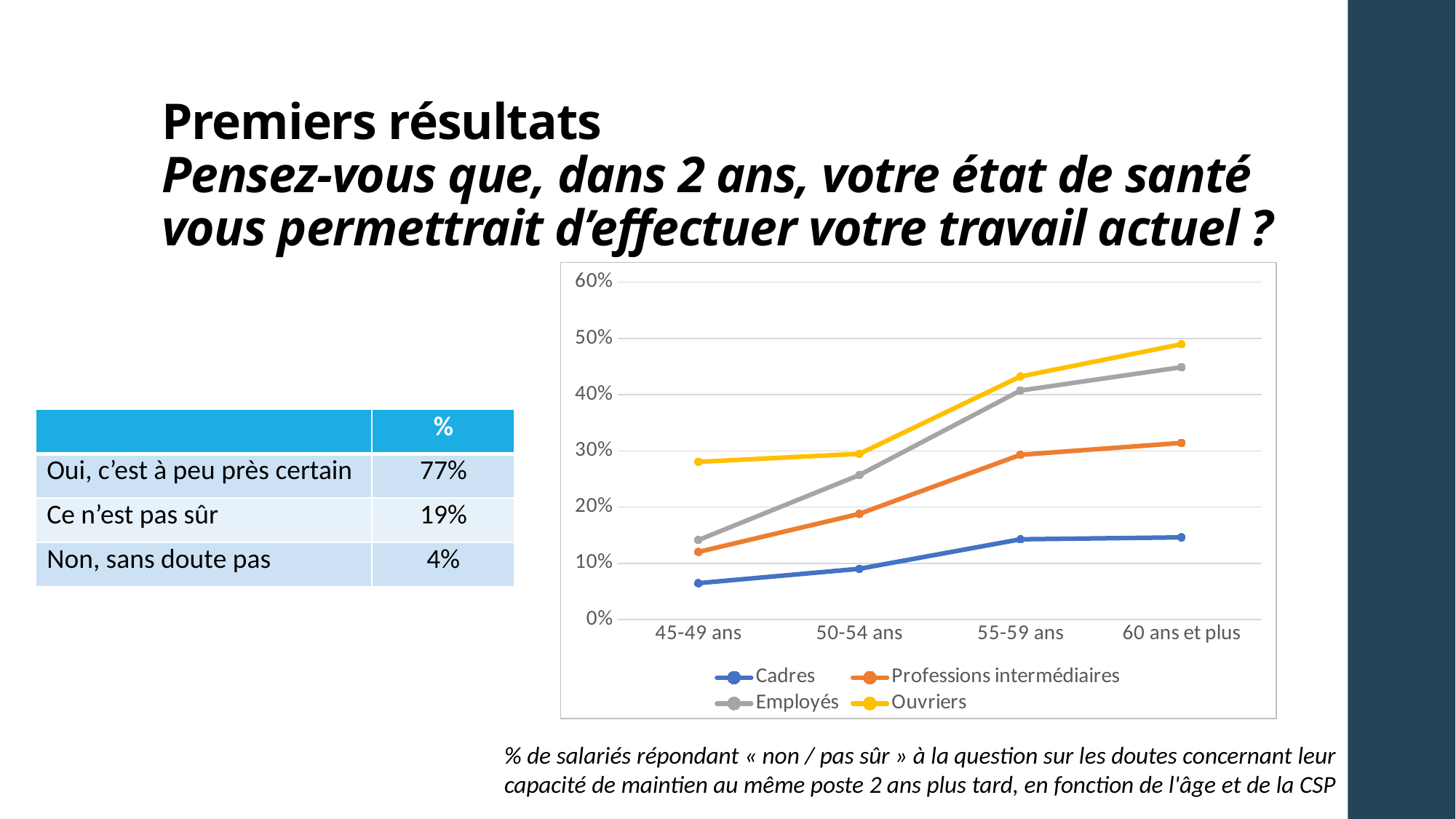
How many series does the chart legend list? 4 Which series is drawn in yellow in the chart? Ouvriers Which series has the lowest value for the '45-49 ans' category? Cadres Do the values for Ouvriers rise or fall from '45-49 ans' to '60 ans et plus'? rise What kind of chart is shown on the slide? line chart Is the value for Employés at '50-54 ans' greater or less than 20%? greater How many age categories are shown on the x axis of the chart? 4 Which series has the highest value for the '60 ans et plus' category? Ouvriers Which is larger at '55-59 ans': the value for Employés or the value for Professions intermédiaires? Employés Is the value for Ouvriers at '55-59 ans' greater or less than 40%? greater Is the value for Cadres at '60 ans et plus' greater or less than 20%? less